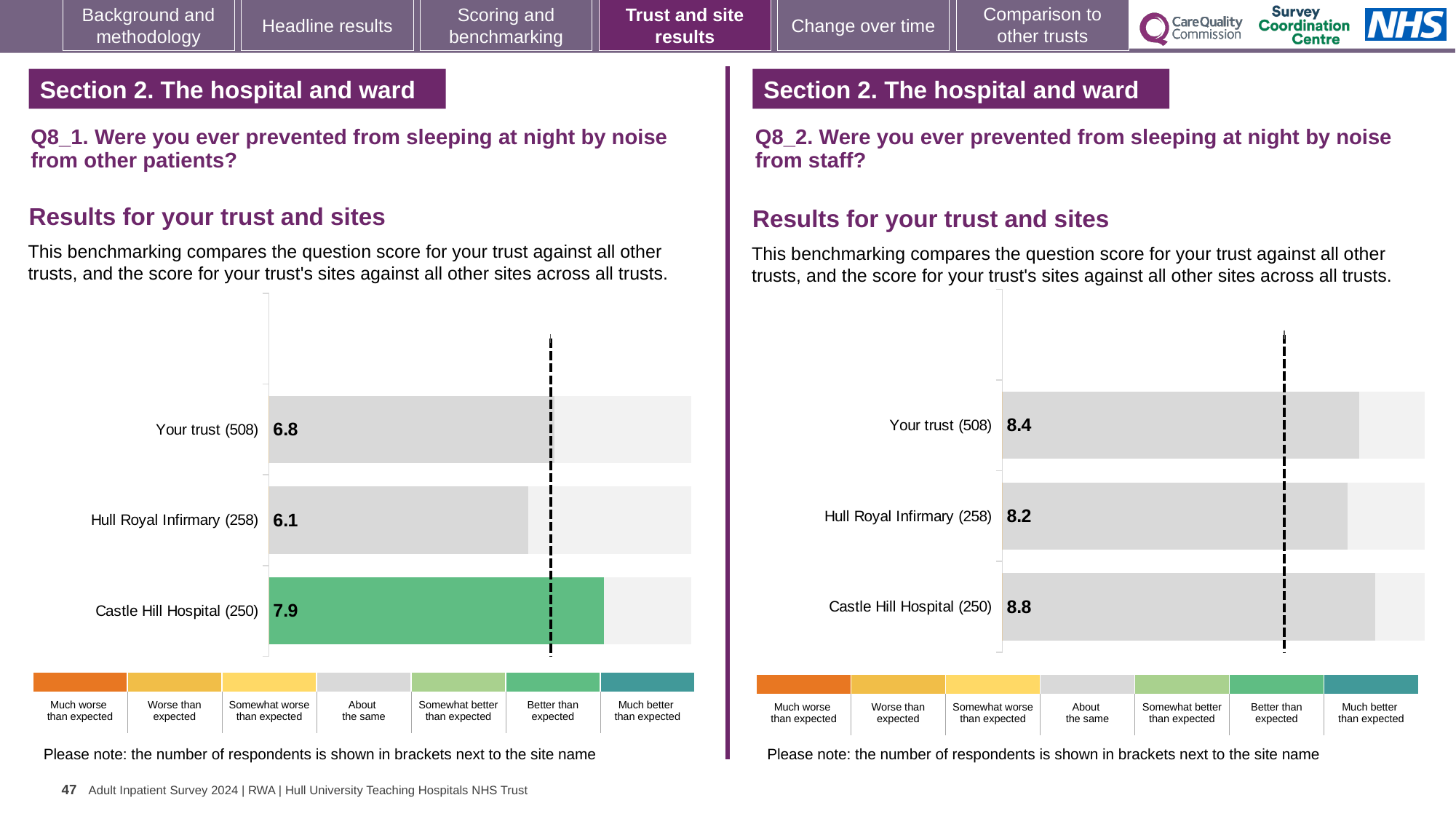
In the Q8_1 chart (left), which site or trust has the lowest score? Hull Royal Infirmary (258) In the Q8_2 chart (right), what is the difference between the scores for Castle Hill Hospital (250) and Your trust (508)? 0.4 In the Q8_2 chart (right), which site or trust has the lowest score? Hull Royal Infirmary (258) In the Q8_1 chart (left), which site or trust has the highest score? Castle Hill Hospital (250) In the Q8_1 chart (left), what is the score for Your trust (508)? 6.8 In the Q8_1 chart (left), what is the score for Castle Hill Hospital (250)? 7.9 In the Q8_2 chart (right), what is the score for Castle Hill Hospital (250)? 8.8 In the Q8_1 chart (left), which bar is coloured green rather than grey? Castle Hill Hospital (250) In the Q8_1 chart (left), what is the difference between the scores for Castle Hill Hospital (250) and Hull Royal Infirmary (258)? 1.8 How many bars are shown in the Q8_1 chart (left)? 3 In the Q8_2 chart (right), which has the larger score: Your trust (508) or Hull Royal Infirmary (258)? Your trust (508) In the Q8_2 chart (right), what is the score for Hull Royal Infirmary (258)? 8.2